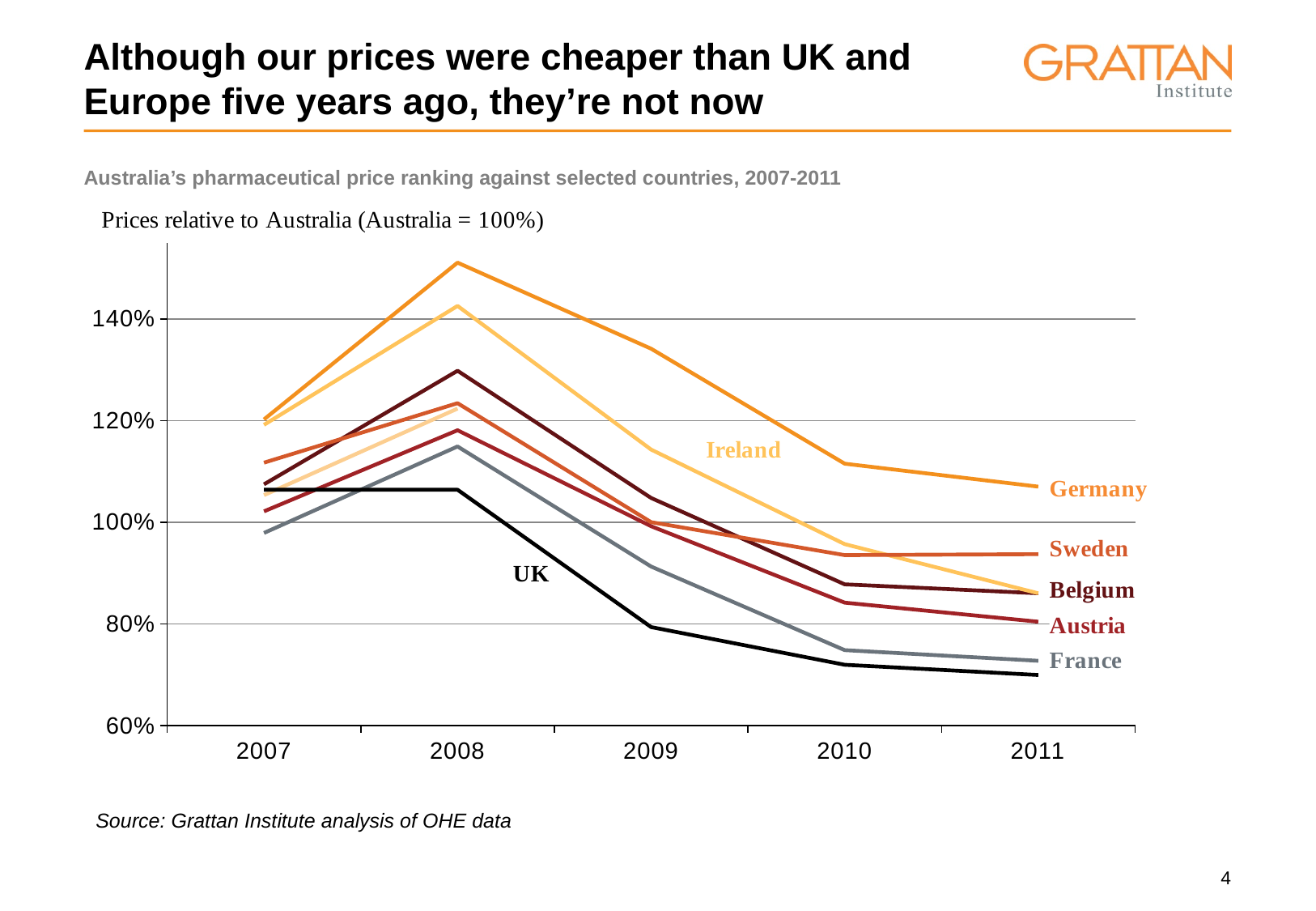
Which country has the lowest price relative to Australia in 2011? UK How many years are shown on the x axis? 5 Which country has the highest price relative to Australia in 2008? Germany Is the value for the UK in 2011 greater or less than 80%? less Is the value for Germany in 2011 greater or less than 100%? greater Does the Germany line rise or fall from 2008 to 2011? Fall Is the value for Germany in 2008 greater or less than 140%? greater Which country has the highest price relative to Australia in 2011? Germany In 2011, which is larger: the value for Germany or the value for France? Germany What kind of chart is shown on the slide? Line chart